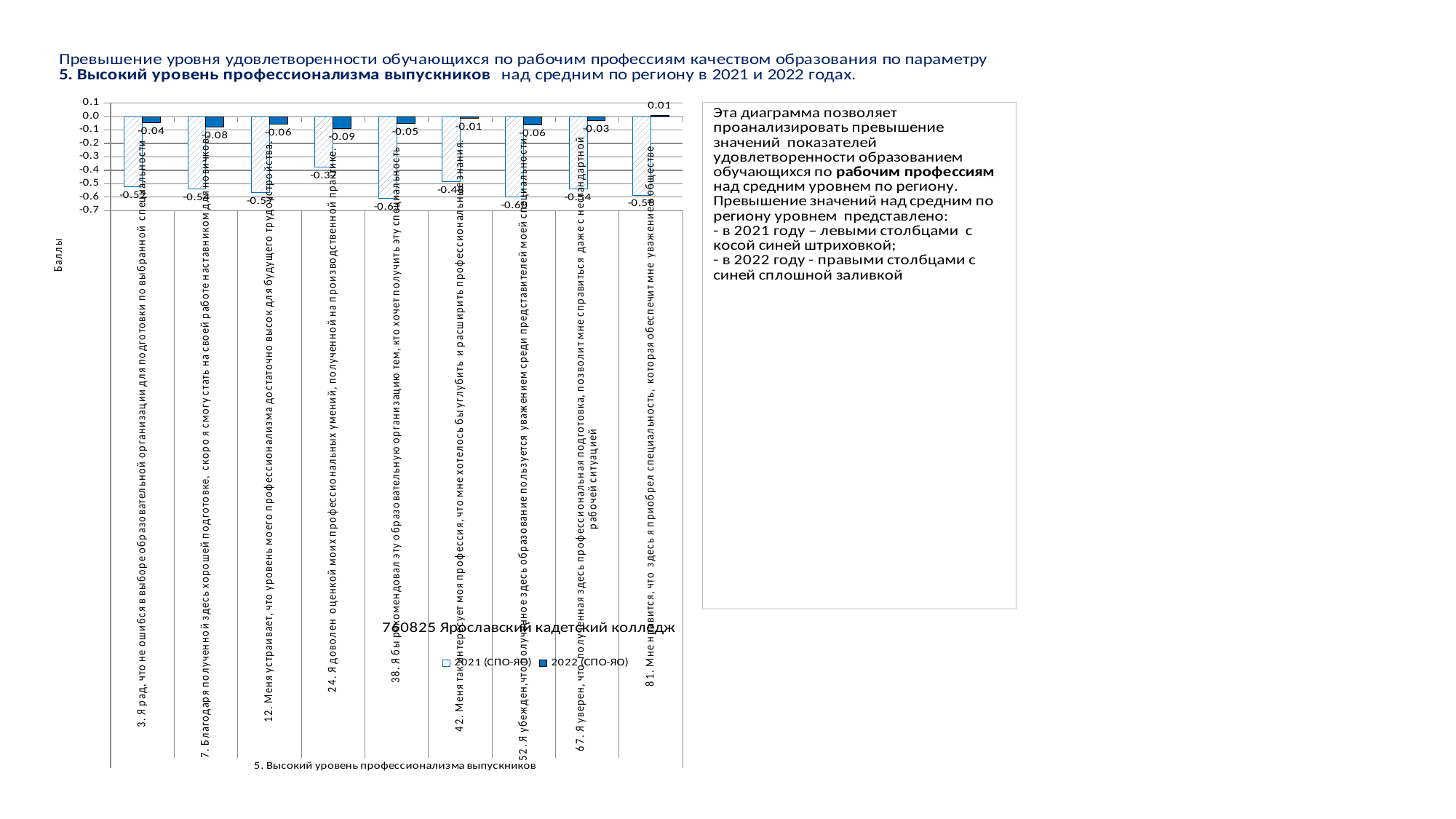
What is the difference between the 2021 and 2022 values for statement 38 (Я бы рекомендовал эту образовательную организацию...)? 0.56 What is the title printed on the chart? 760825 Ярославский кадетский колледж Which statement has the lowest 2021 (СПО-ЯО) value? 38. Я бы рекомендовал эту образовательную организацию тем, кто хочет получить эту специальность What is the 2021 (СПО-ЯО) value for statement 24 (Я доволен оценкой моих профессиональных умений...)? -0.37 Which statement has the highest 2022 (СПО-ЯО) value? 81. Мне нравится, что здесь я приобрел специальность, которая обеспечит мне уважение в обществе How many statement categories are plotted along the x axis? 9 How many series does the chart legend list? 2 What type of chart is shown on the slide? bar chart What is the 2022 (СПО-ЯО) value for statement 81 (Мне нравится, что здесь я приобрел специальность...)? 0.01 Which statement has the lowest 2022 (СПО-ЯО) value? 24. Я доволен оценкой моих профессиональных умений, полученной на производственной практике Which is larger for statement 42 (Меня так интересует моя профессия...): the 2021 (СПО-ЯО) value or the 2022 (СПО-ЯО) value? 2022 (СПО-ЯО) What is the 2022 (СПО-ЯО) value for statement 24 (Я доволен оценкой моих профессиональных умений...)? -0.09